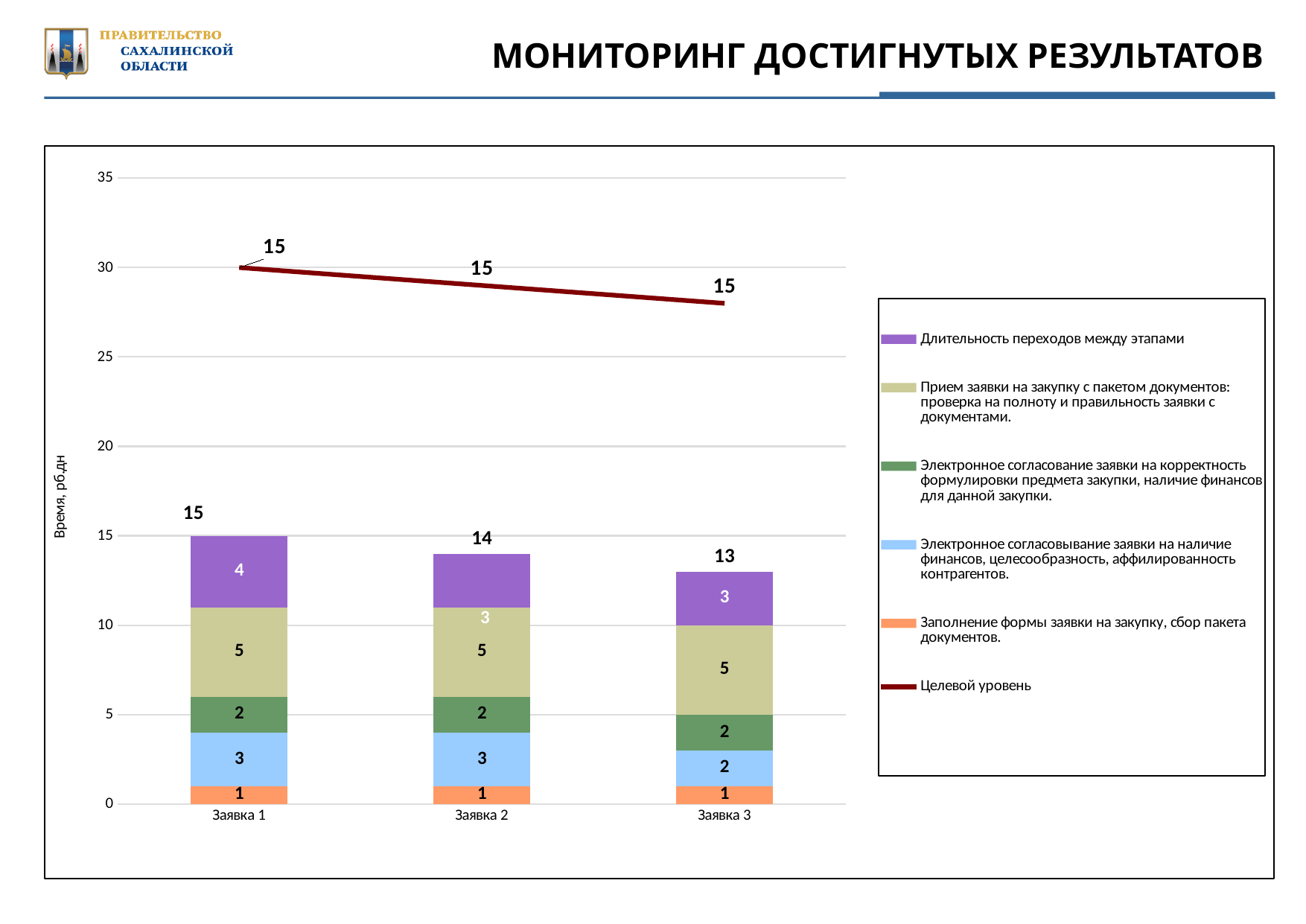
Which is larger: the 'Длительность переходов между этапами' segment for Заявка 1 or for Заявка 3? Заявка 1 What is the value of the 'Заполнение формы заявки на закупку, сбор пакета документов' segment for Заявка 2? 1 Which category has the lowest total bar value? Заявка 3 What is the difference between the total for Заявка 1 and the total for Заявка 3? 2 Which category has the highest total bar value? Заявка 1 What is the total of the stacked bar for Заявка 2? 14 What is the value of the 'Длительность переходов между этапами' segment for Заявка 1? 4 How many series does the legend list? 6 Do the total bar values rise or fall from Заявка 1 to Заявка 3? Fall What is the value of the 'Электронное согласовывание заявки на наличие финансов, целесообразность, аффилированность контрагентов' segment for Заявка 3? 2 What kind of chart is shown on the slide? Stacked bar chart with a line How many categories are shown on the x axis? 3